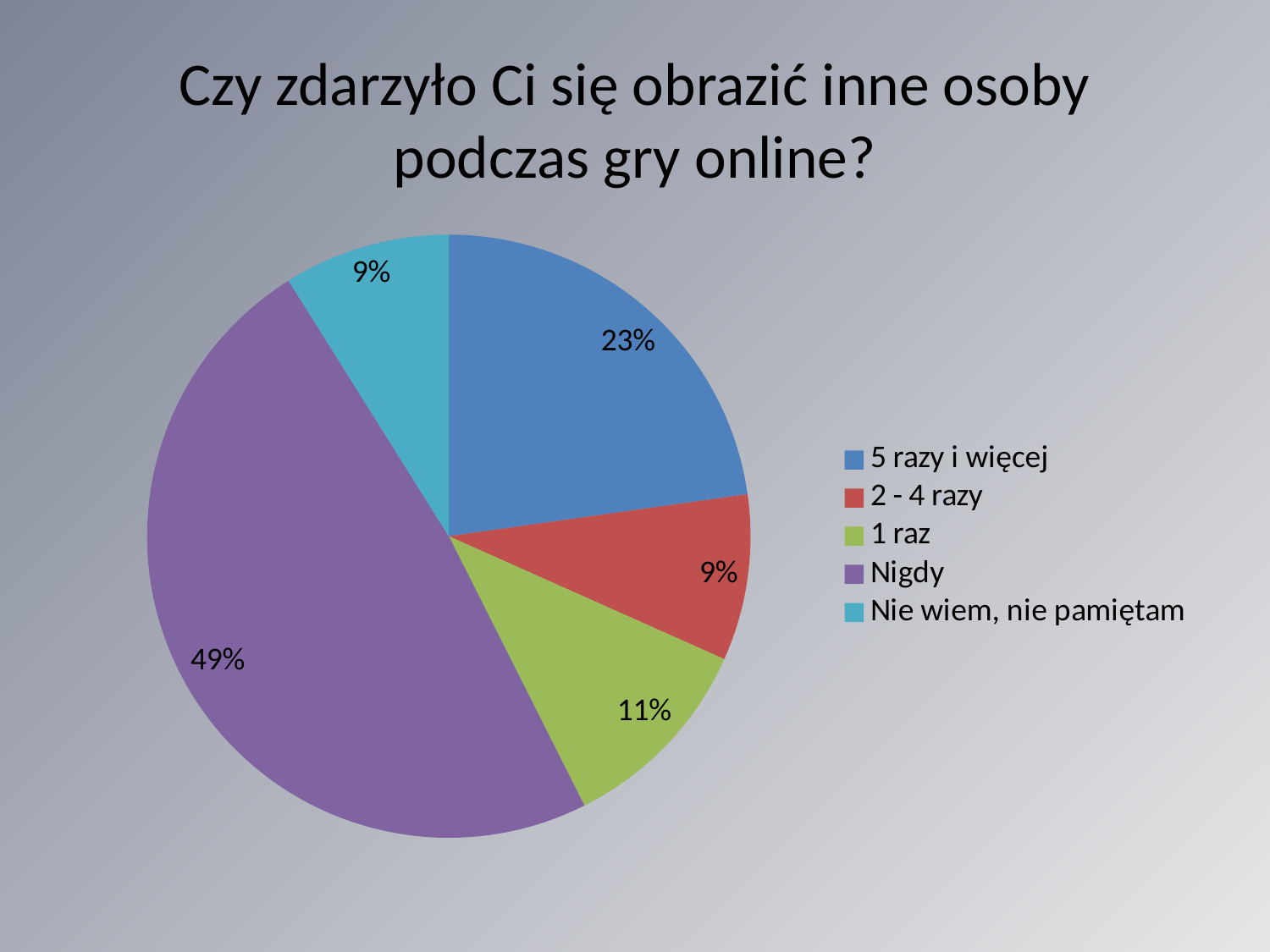
How many categories does the legend list? 5 What is the title of the chart? Czy zdarzyło Ci się obrazić inne osoby podczas gry online? What is the value for "1 raz"? 11% What is the value for "Nie wiem, nie pamiętam"? 9% What kind of chart is shown on the slide? pie chart What is the difference between the values for "Nigdy" and "5 razy i więcej"? 26% What is the value for "5 razy i więcej"? 23% What colour is the slice for "Nigdy"? purple What is the value for "2 - 4 razy"? 9% Which category has the largest slice? Nigdy What share of the pie does "Nigdy" take? 49% Which is larger, the value for "1 raz" or the value for "2 - 4 razy"? 1 raz